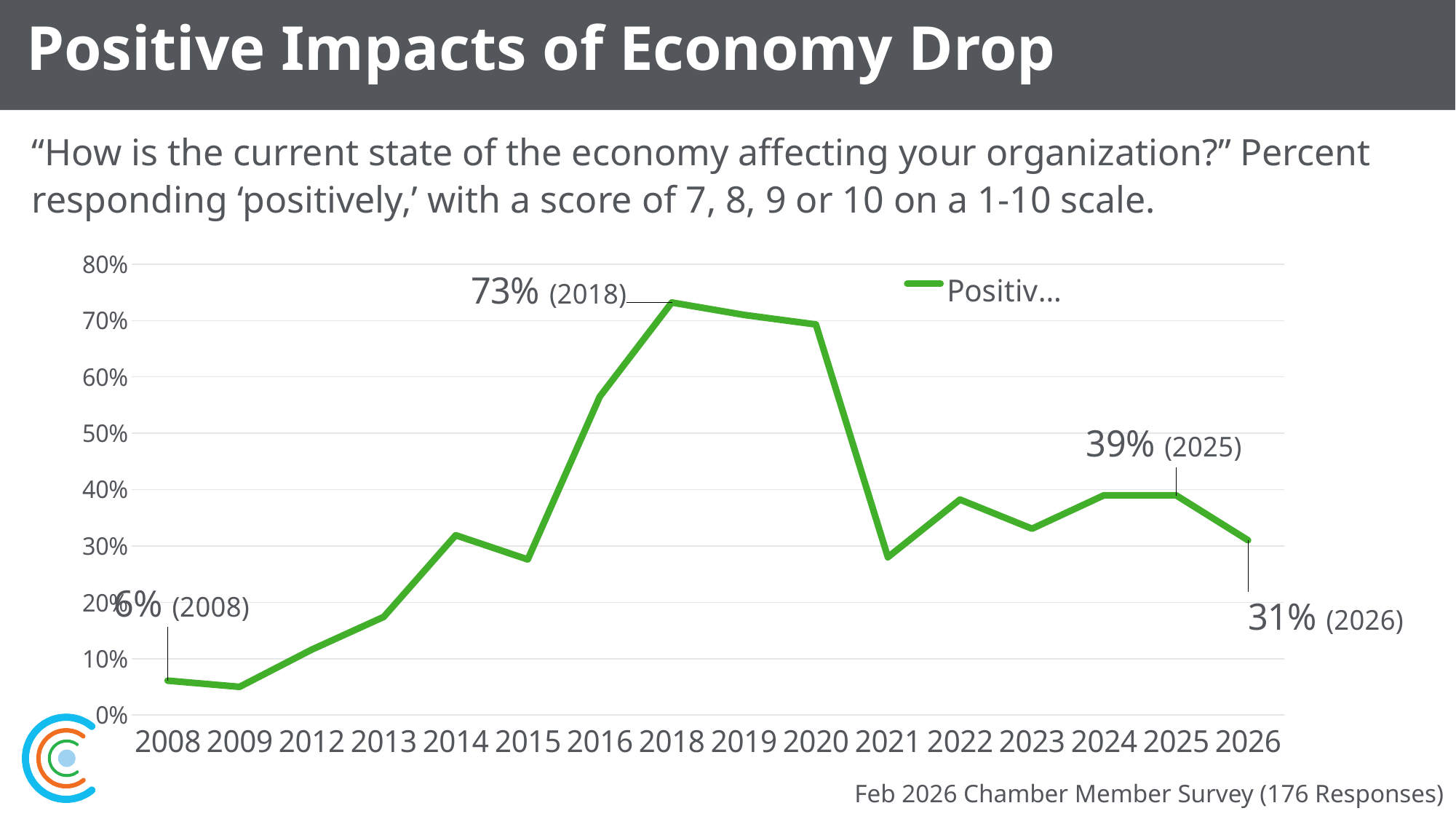
What is the value for 2025? 39% How many years are plotted on the x axis? 16 What is the difference between the values for 2018 and 2026? 42 percentage points What is the difference between the values for 2025 and 2026? 8 percentage points Which year has the highest value? 2018 Is the value for 2020 greater or less than 60%? greater What is the value for 2018? 73% Is the value for 2021 greater or less than 30%? less What kind of chart is this? line chart What is the value for 2026? 31% Which is larger, the value for 2025 or the value for 2026? 2025 What is the value for 2008? 6%